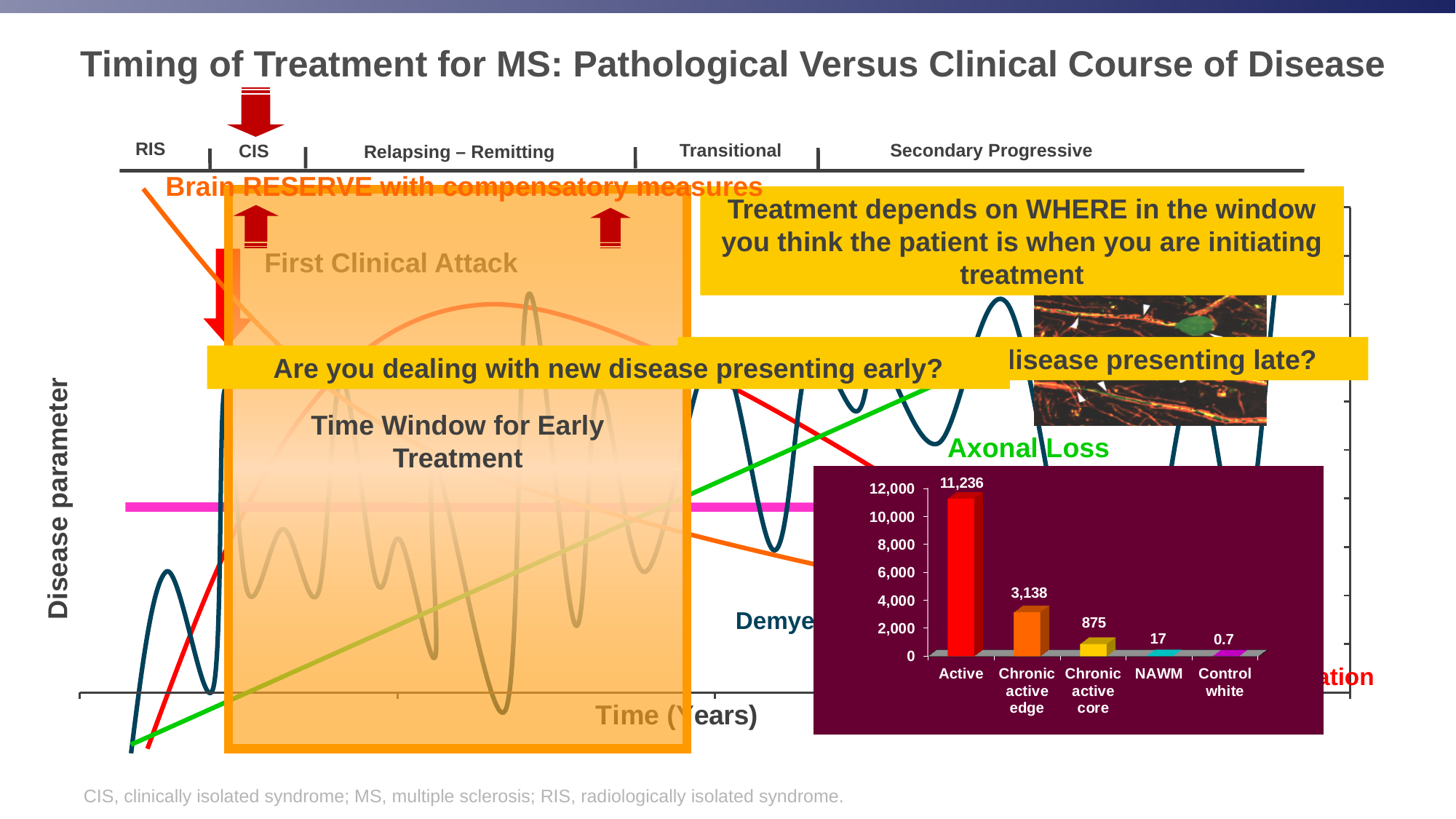
In the bar chart on the maroon panel, what is the value for Active? 11,236 In the bar chart on the maroon panel, what is the value for Chronic active core? 875 In the bar chart on the maroon panel, which category has the highest value? Active What kind of chart is shown on the maroon panel in the lower right of the slide? bar chart In the bar chart on the maroon panel, what is the value for Chronic active edge? 3,138 In the bar chart on the maroon panel, what is the difference between the values for Active and Chronic active edge? 8,098 In the bar chart on the maroon panel, what is the value for Control white? 0.7 How many categories are shown in the bar chart on the maroon panel? 5 In the bar chart on the maroon panel, is the value for Chronic active edge greater or less than 4,000? less In the bar chart on the maroon panel, which category has the lowest value? Control white In the bar chart on the maroon panel, what is the value for NAWM? 17 In the bar chart on the maroon panel, which is larger, the value for Chronic active core or the value for NAWM? Chronic active core